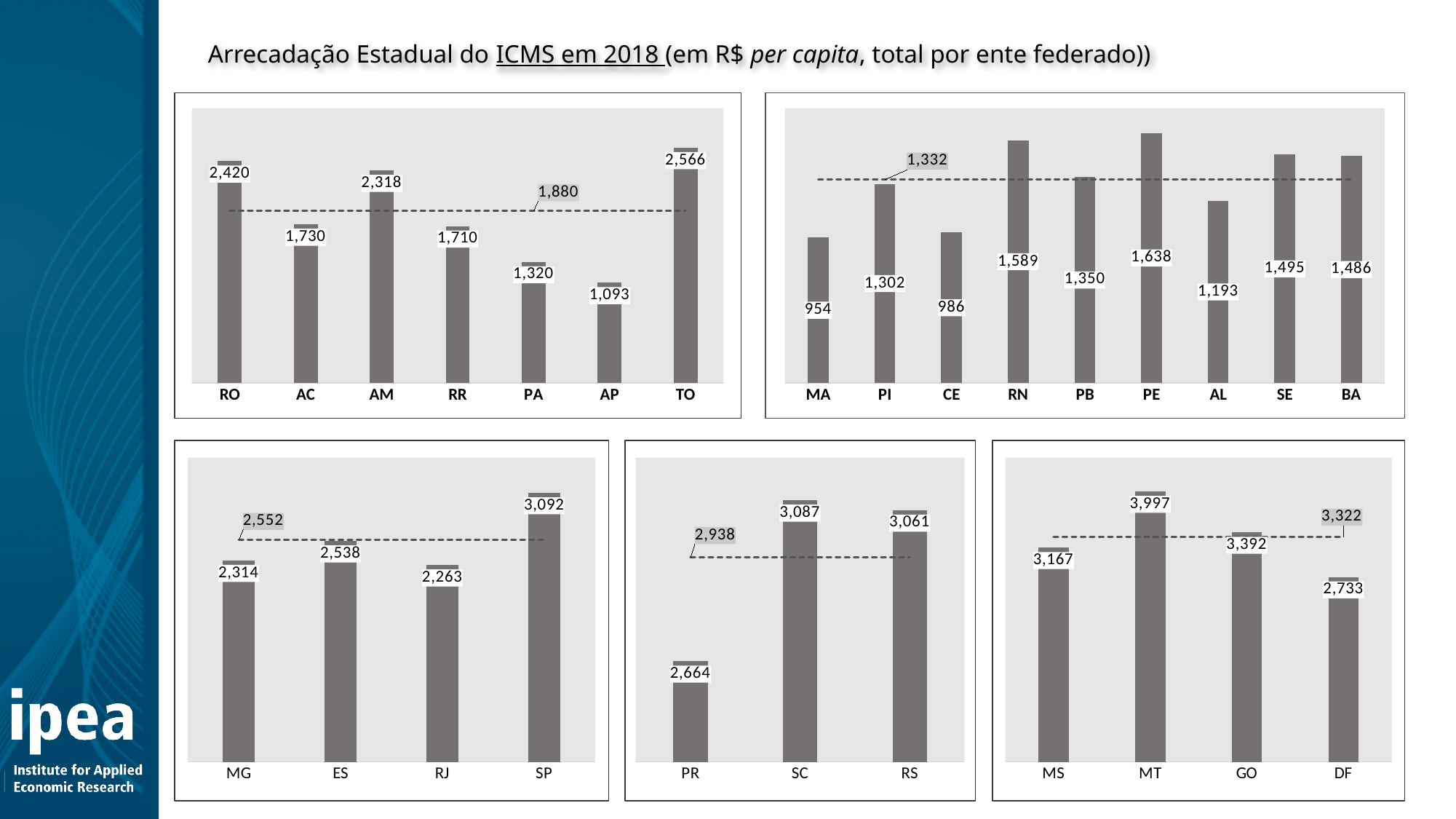
In the top-right chart, which state has the lowest value? MA In the bottom-right chart, what is the value for MT? 3,997 In the top-left chart, what is the value for TO? 2,566 In the bottom-left chart, what is the difference between the values for SP and RJ? 829 What kind of chart is the bottom-left chart? bar chart In the top-left chart, what is the value for AP? 1,093 How many states are shown in the top-right chart? 9 In the top-right chart, which state has the highest value? PE In the top-left chart, which state has the lowest value? AP In the bottom-middle chart, which is larger, the value for PR or the value for SC? SC What value is marked by the dashed line in the bottom-middle chart? 2,938 In the bottom-right chart, what is the difference between the values for MT and DF? 1,264